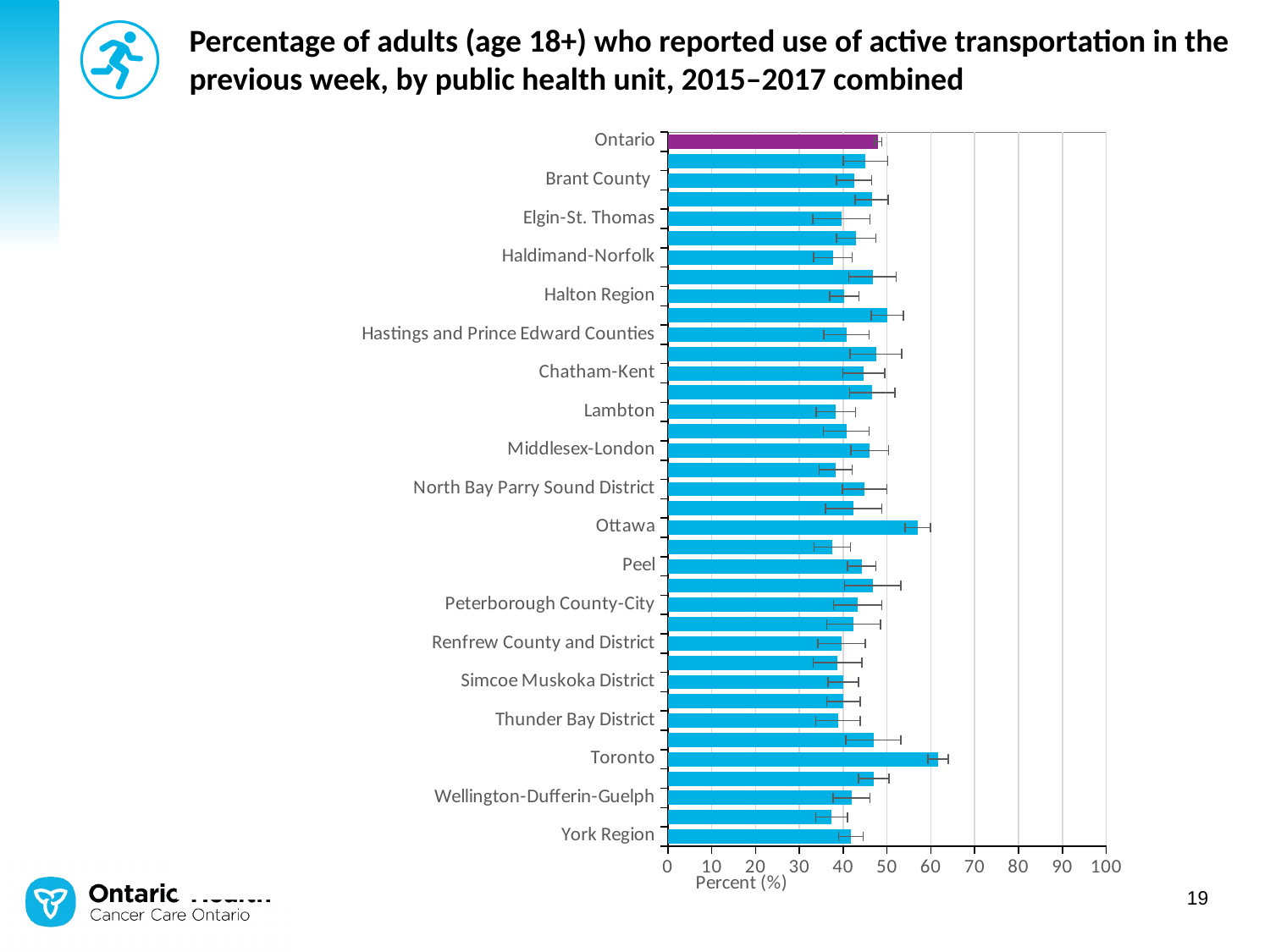
Is the value for Middlesex-London greater or less than 40? greater Which bar is shown in a different colour (purple) from the rest? Ontario Is the value for Haldimand-Norfolk greater or less than 40? less Which has a higher value, Toronto or Ottawa? Toronto Which has a higher value, Lambton or Toronto? Toronto Which has a higher value, Ottawa or Ontario? Ottawa Is the value for Ottawa greater or less than 50? greater What is the label of the horizontal axis? Percent (%) Which public health unit has the highest percentage of adults reporting use of active transportation? Toronto What kind of chart is shown on the slide? Bar chart